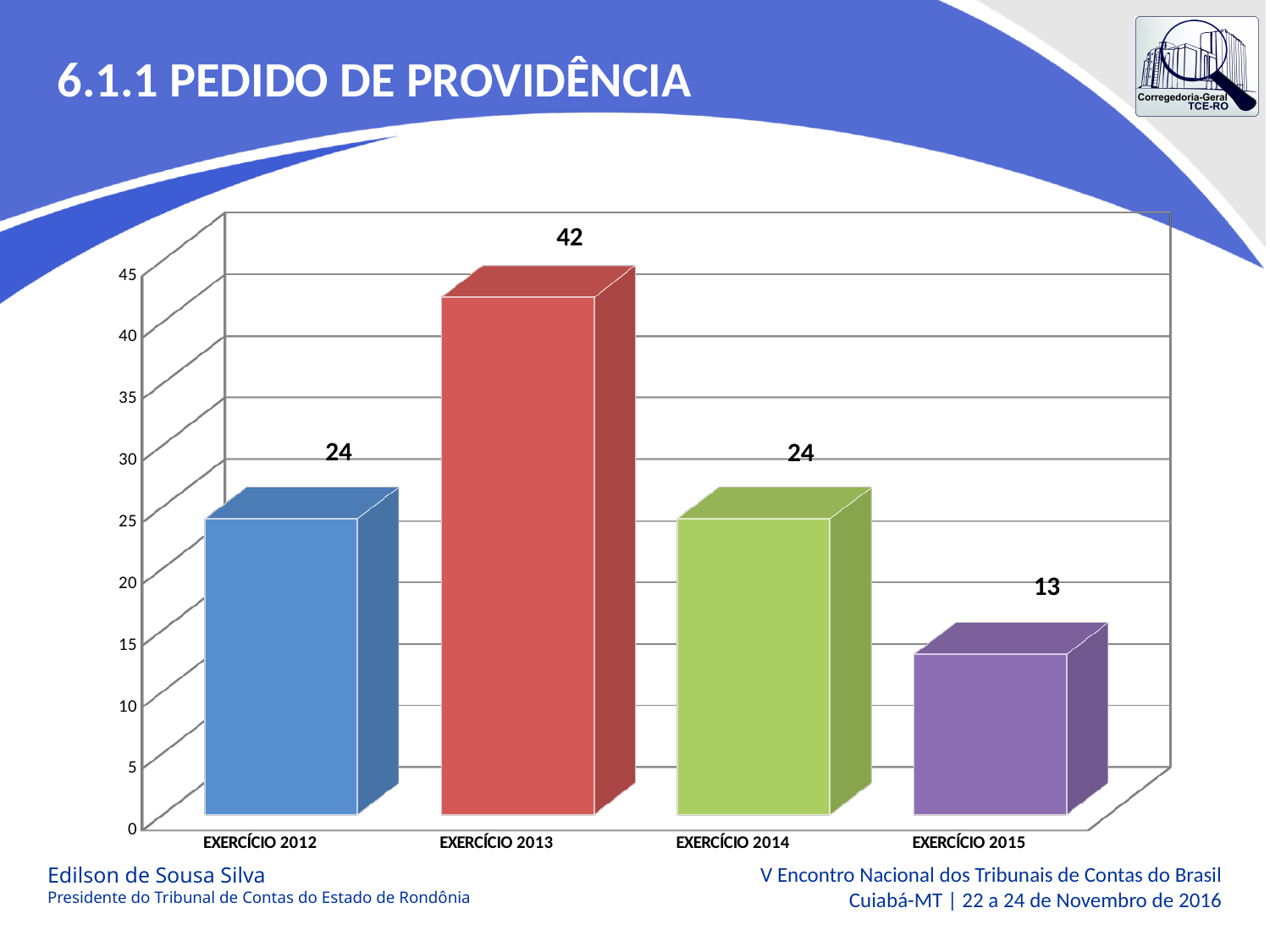
Is the value for EXERCÍCIO 2013 greater or less than 40? greater What is the difference between the values for EXERCÍCIO 2013 and EXERCÍCIO 2014? 18 What is the value for EXERCÍCIO 2015? 13 Which is larger, the value for EXERCÍCIO 2014 or the value for EXERCÍCIO 2015? EXERCÍCIO 2014 What kind of chart is shown on the slide? bar chart How many categories are shown on the chart? 4 What is the value for EXERCÍCIO 2012? 24 Which category has the highest value? EXERCÍCIO 2013 Which category has the lowest value? EXERCÍCIO 2015 What is the difference between the values for EXERCÍCIO 2013 and EXERCÍCIO 2015? 29 What is the value for EXERCÍCIO 2013? 42 What is the title of the slide containing the chart? 6.1.1 PEDIDO DE PROVIDÊNCIA